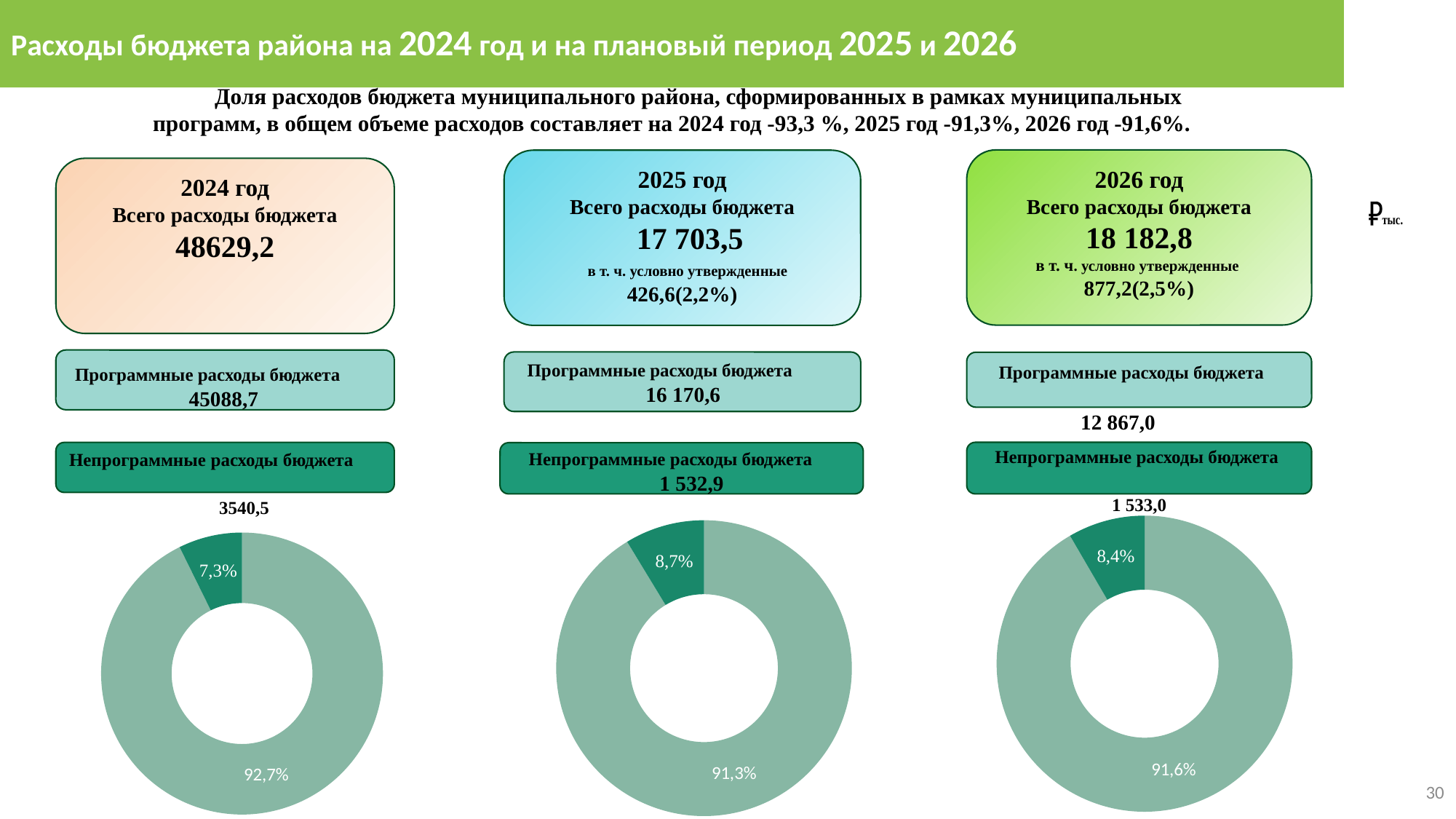
In the right donut chart (2026), what share is shown for the large light-green slice? 91,6% In the right donut chart (2026), what share is shown for the small dark-green slice? 8,4% In the middle donut chart (2025), what share is shown for the large light-green slice? 91,3% Which of the three donut charts shows the smallest dark-green (non-programme) slice: 2024, 2025 or 2026? 2024 Is the dark-green slice in the middle donut chart (2025) larger or smaller than the dark-green slice in the left donut chart (2024)? larger What is the difference between the light-green slice shares in the left (2024) and middle (2025) donut charts? 1,4% Which of the three donut charts shows the largest dark-green (non-programme) slice: 2024, 2025 or 2026? 2025 What kind of chart is shown under the 2024 year block on the left of the slide? Donut (pie) chart How many slices does each donut chart on the slide have? 2